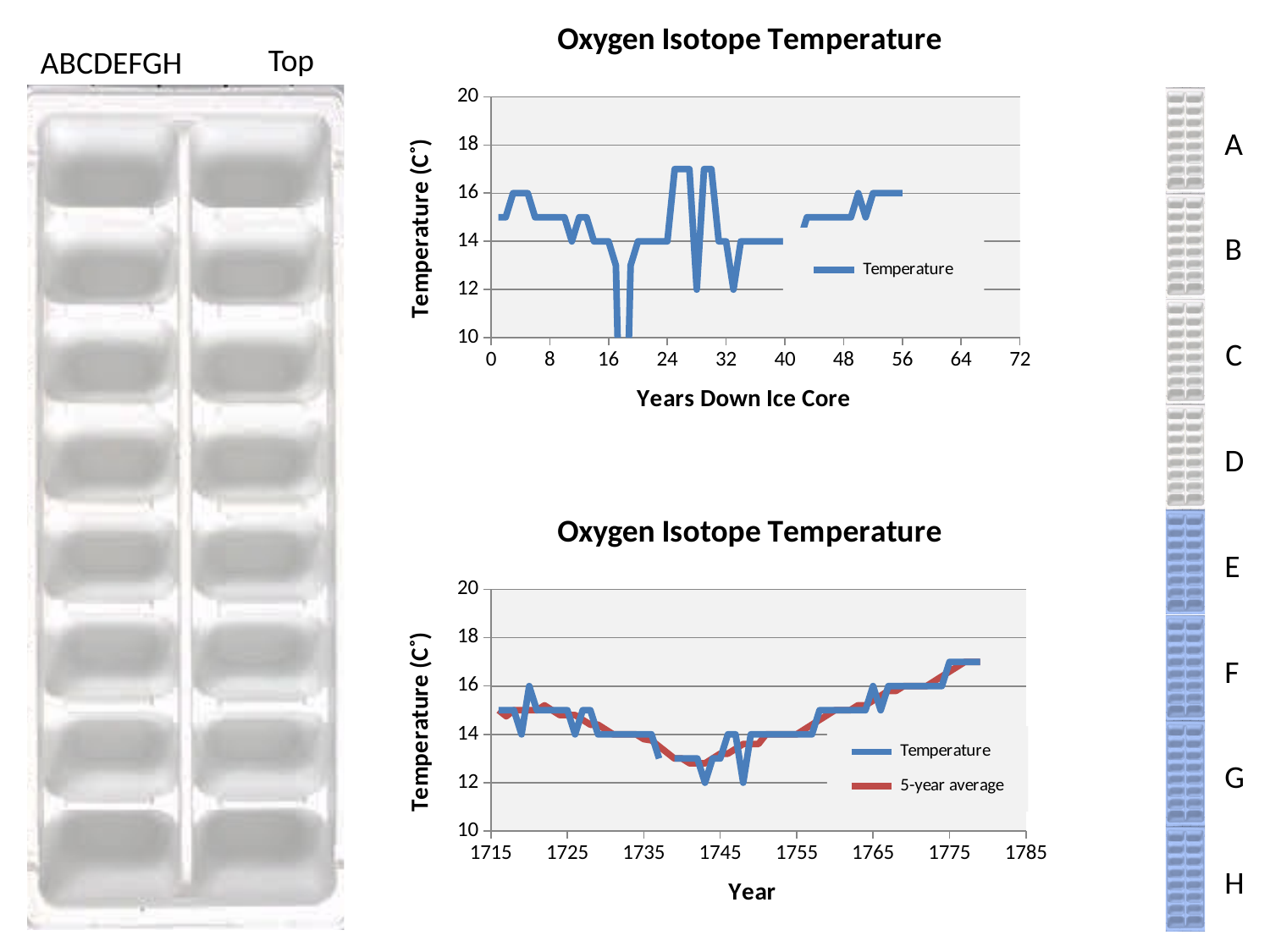
In the bottom chart (Year), what is the name of the series drawn in red? 5-year average In the bottom chart (Year), does the 5-year average rise or fall between 1720 and 1743? fall How many series does the legend of the top chart (Years Down Ice Core) list? 1 How many series does the legend of the bottom chart (Year) list? 2 In the bottom chart (Year), is the Temperature value at 1743 greater or less than 14? less What is the x-axis title of the top chart? Years Down Ice Core In the bottom chart (Year), is the Temperature value at 1775 greater or less than 16? greater In the bottom chart (Year), does the 5-year average rise or fall between 1755 and 1775? rise What kind of chart is the bottom chart, with x axis 'Year'? line chart What kind of chart is the top chart, with x axis 'Years Down Ice Core'? line chart In the top chart (Years Down Ice Core), is the Temperature value at 26 years greater or less than 16? greater